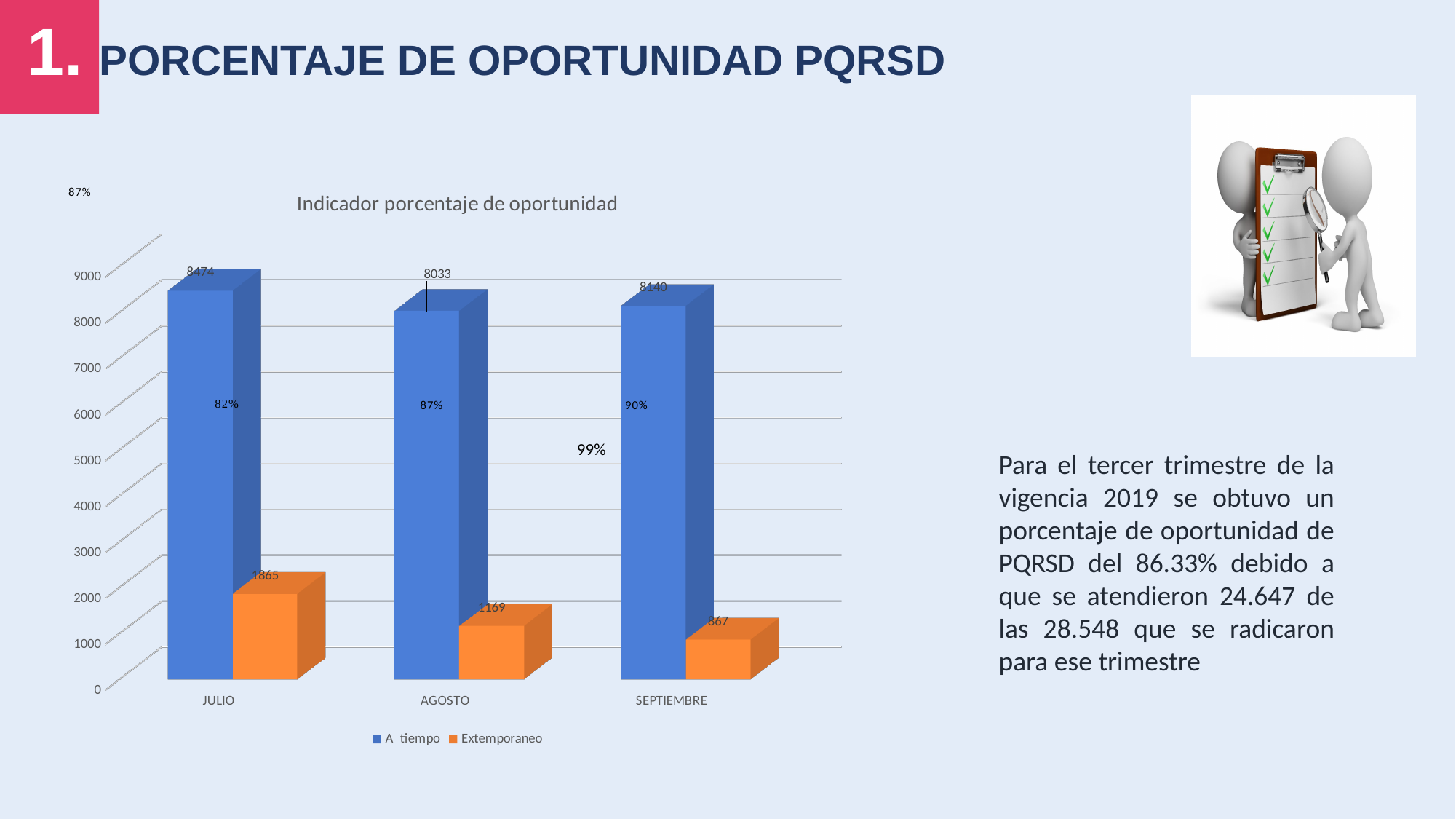
Which month has the highest A tiempo value? JULIO What kind of chart is shown? Bar chart What is the value of Extemporaneo for AGOSTO? 1169 Which month has the lowest Extemporaneo value? SEPTIEMBRE Do the Extemporaneo values rise or fall from JULIO to SEPTIEMBRE? Fall What is the difference between the A tiempo values for JULIO and AGOSTO? 441 How many series does the legend list? 2 What is the title of the chart? Indicador porcentaje de oportunidad What is the value of A tiempo for JULIO? 8474 How many months are shown on the x axis? 3 What is the value of Extemporaneo for SEPTIEMBRE? 867 Which is larger, the A tiempo value for SEPTIEMBRE or for AGOSTO? SEPTIEMBRE